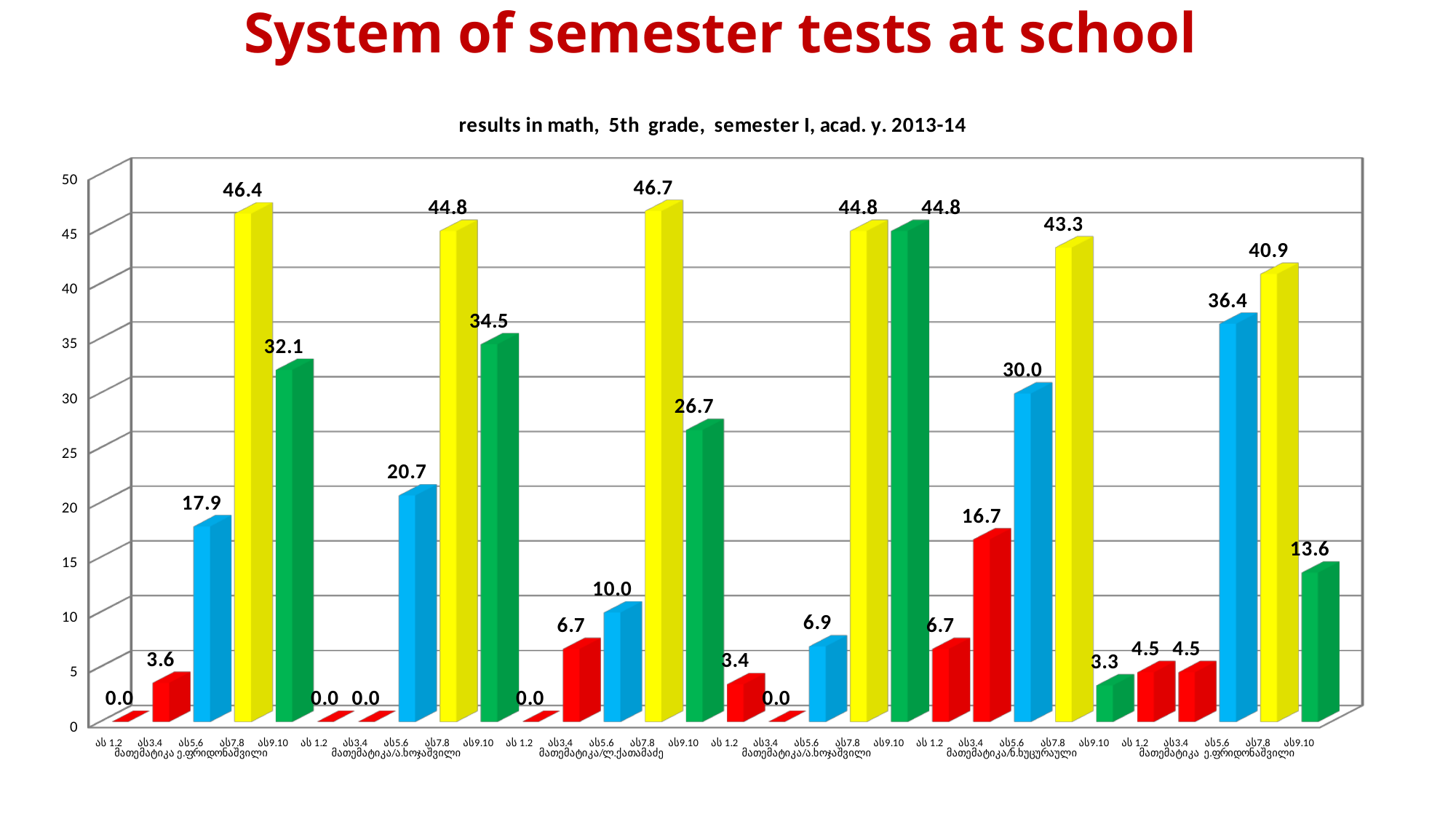
In the first group of bars (leftmost), what is the value for ას7.8? 46.4 What is the title of the chart? results in math, 5th grade, semester I, acad. y. 2013-14 Which bar has the highest value in the whole chart? ას7.8 in the third group, 46.7 In the fifth group, which is larger: the value for ას3.4 or the value for ას5.6? ას5.6 In the second group, what is the value for ას5.6? 20.7 How many groups of bars (teacher groups) are shown along the x axis? 6 What is the difference between the ას7.8 value (46.4) and the ას9.10 value (32.1) in the first group? 14.3 What type of chart is shown on the slide? bar chart In the fifth group of bars, what is the value for ას5.6? 30.0 In the third group of bars, what is the value for ას9.10? 26.7 What colour are the bars for ას7.8? yellow In the sixth group of bars (rightmost), which score band has the lowest value? ას 1.2 and ას3.4 (both 4.5)